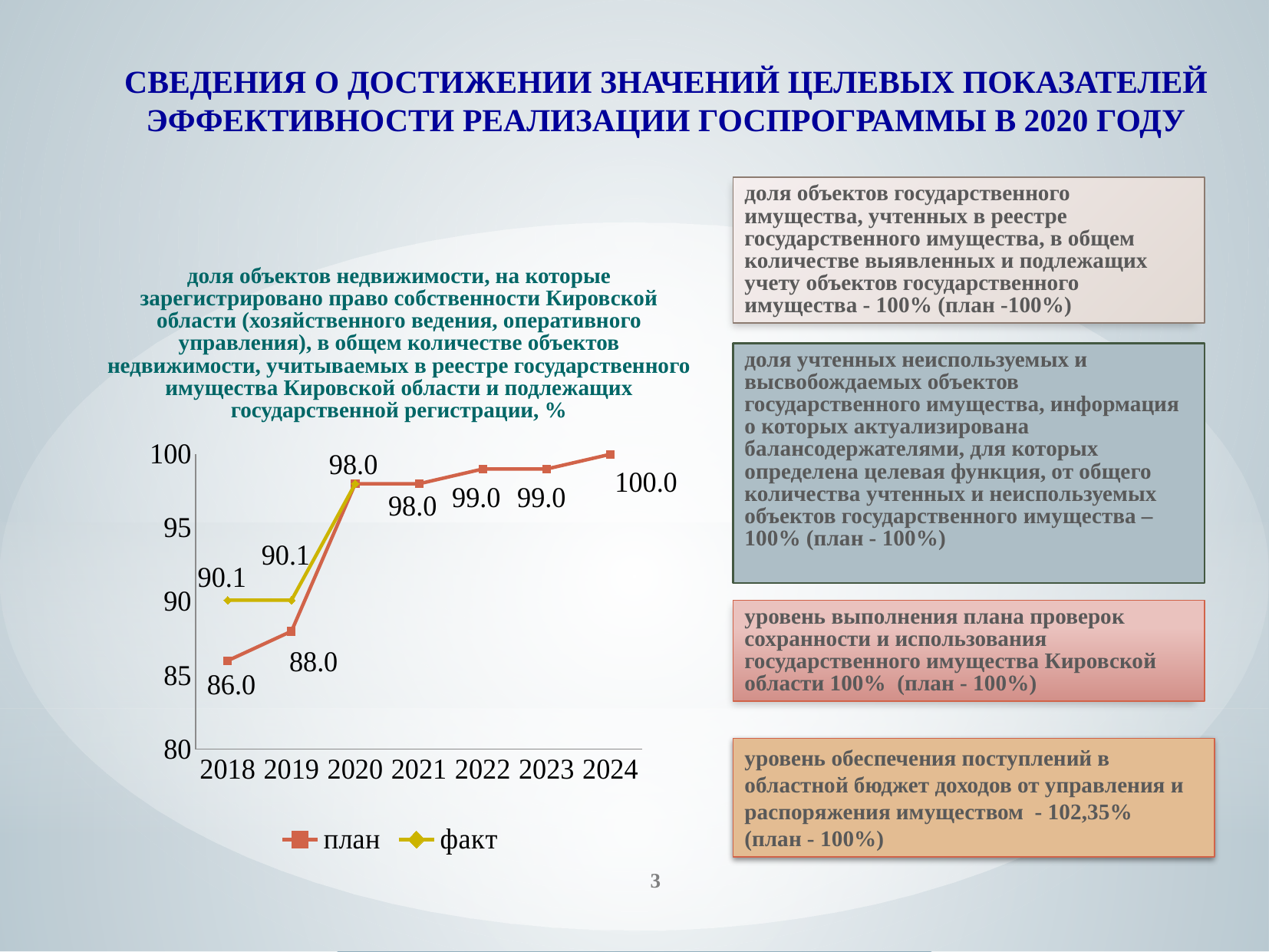
What is the value of the факт series for 2018? 90.1 What kind of chart is shown on the slide? line chart What are the two series named in the chart legend? план and факт By how much does the план value for 2020 exceed the план value for 2019? 10.0 In which year is the план series at its lowest value? 2018 What is the value of the план series for 2018? 86.0 How many series does the chart legend list? 2 In 2019, which series has the larger value, план or факт? факт By how much does the факт value exceed the план value in 2018? 4.1 What is the value of the план series for 2022? 99.0 How many years are shown on the x axis of the chart? 7 What is the value of the план series for 2024? 100.0